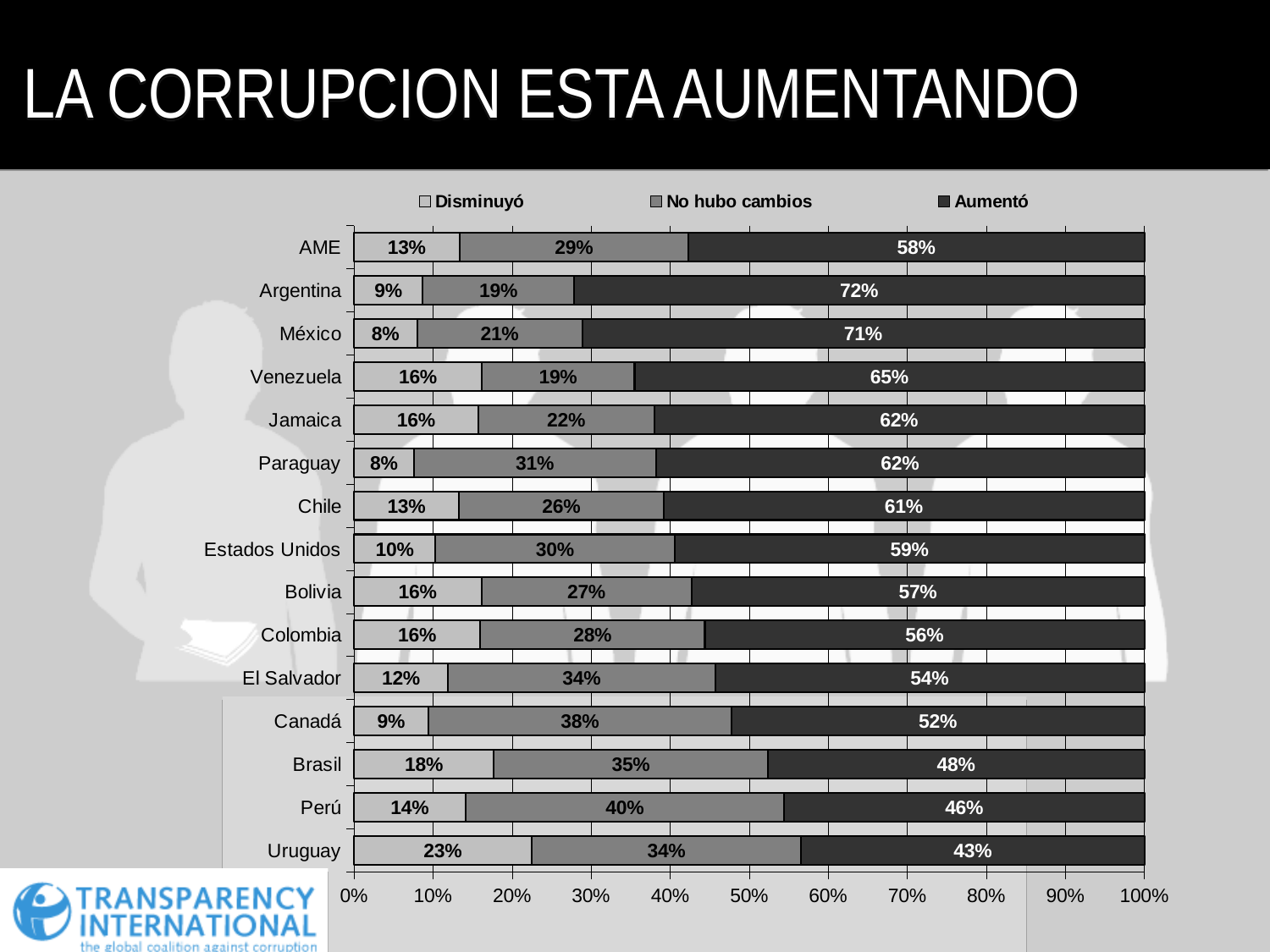
What is the total of the three segments for the AME bar? 100% What is the "No hubo cambios" value for Perú? 40% Which category has the lowest "Aumentó" percentage? Uruguay What is the difference between the "Aumentó" values for México and Brasil? 23% What is the title of the slide? LA CORRUPCION ESTA AUMENTANDO Which country has the highest "Aumentó" percentage? Argentina What kind of chart is shown on the slide? Stacked bar chart What percentage of respondents in Argentina said corruption "Aumentó"? 72% Which is larger, the "No hubo cambios" value for Canadá or for Chile? Canadá How many series does the legend list? 3 What is the "Disminuyó" value for Uruguay? 23% How many countries or regions are listed on the vertical axis? 15